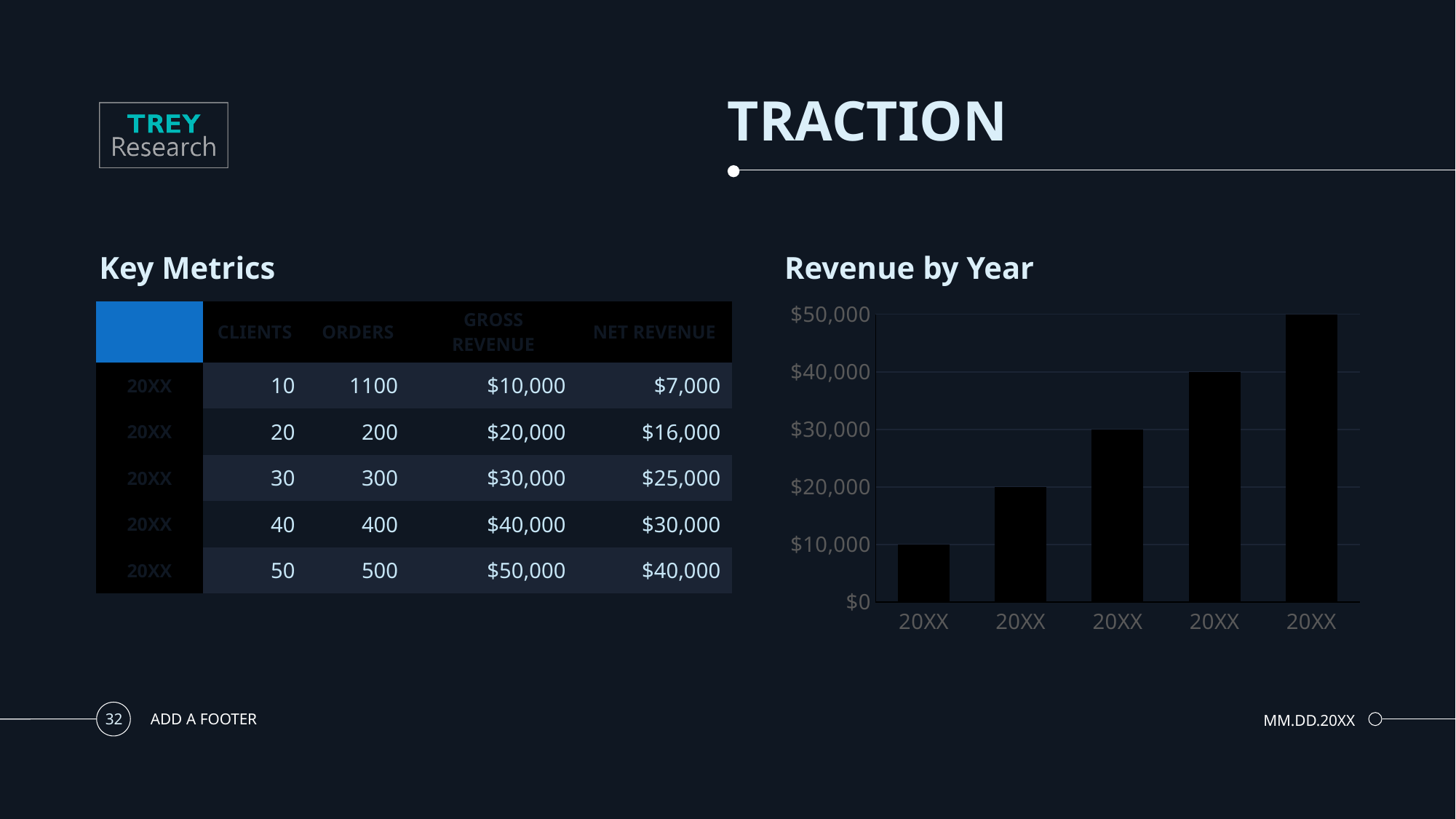
In the Revenue by Year chart, what is the value of the last (rightmost) bar? $50,000 What is the title of the chart on the slide? Revenue by Year In the Revenue by Year chart, which bar is the shortest? the leftmost (first) bar In the Revenue by Year chart, do the values rise or fall from left to right? rise In the Revenue by Year chart, what is the value of the first (leftmost) bar? $10,000 How many bars are plotted in the Revenue by Year chart? 5 In the Revenue by Year chart, which bar is the tallest? the rightmost (fifth) bar In the Revenue by Year chart, is the value of the second bar greater or less than $30,000? less In the Revenue by Year chart, what is the value of the third bar? $30,000 In the Revenue by Year chart, what is the difference between the fifth bar and the first bar? $40,000 In the Revenue by Year chart, is the fourth bar taller or shorter than the second bar? taller What kind of chart is the Revenue by Year chart? bar chart